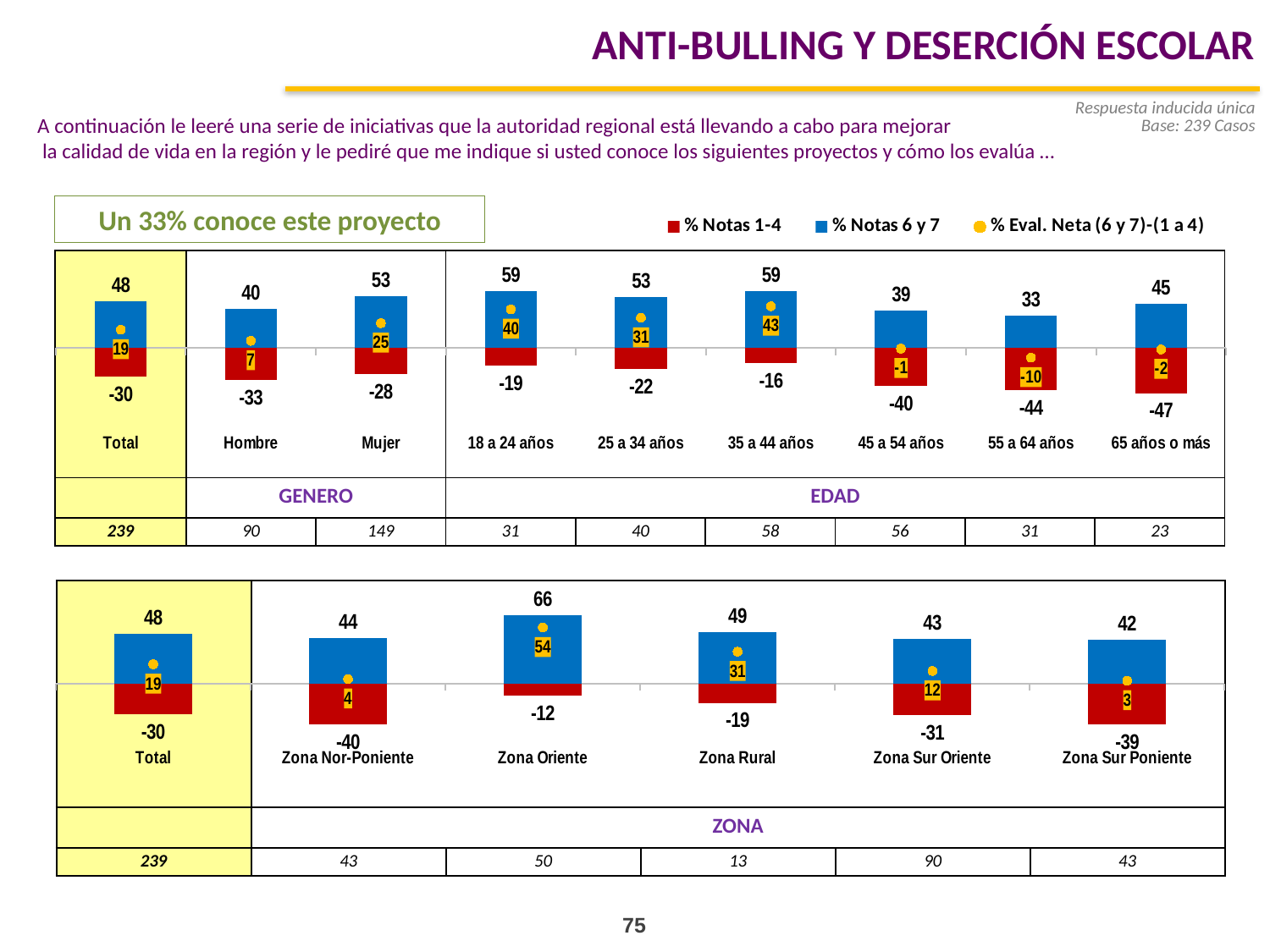
In the top chart, which age group has the lowest % Notas 6 y 7 value? 55 a 64 años In the top chart, what is the % Notas 6 y 7 value for Mujer? 53 What kind of chart is the bottom chart? Bar chart In the bottom chart, how many zones are shown besides Total? 5 How many series does the legend list? 3 In the top chart, what is the % Eval. Neta value for 35 a 44 años? 43 In the bottom chart, what is the % Notas 1-4 value for Zona Nor-Poniente? -40 In the bottom chart, which zone has the highest % Eval. Neta value? Zona Oriente In the top chart, what is the % Notas 1-4 value for 65 años o más? -47 In the top chart, which has a higher % Eval. Neta value, Hombre or Mujer? Mujer In the top chart, what is the difference between the % Notas 6 y 7 values for Mujer and Hombre? 13 In the bottom chart, what is the % Notas 6 y 7 value for Zona Oriente? 66